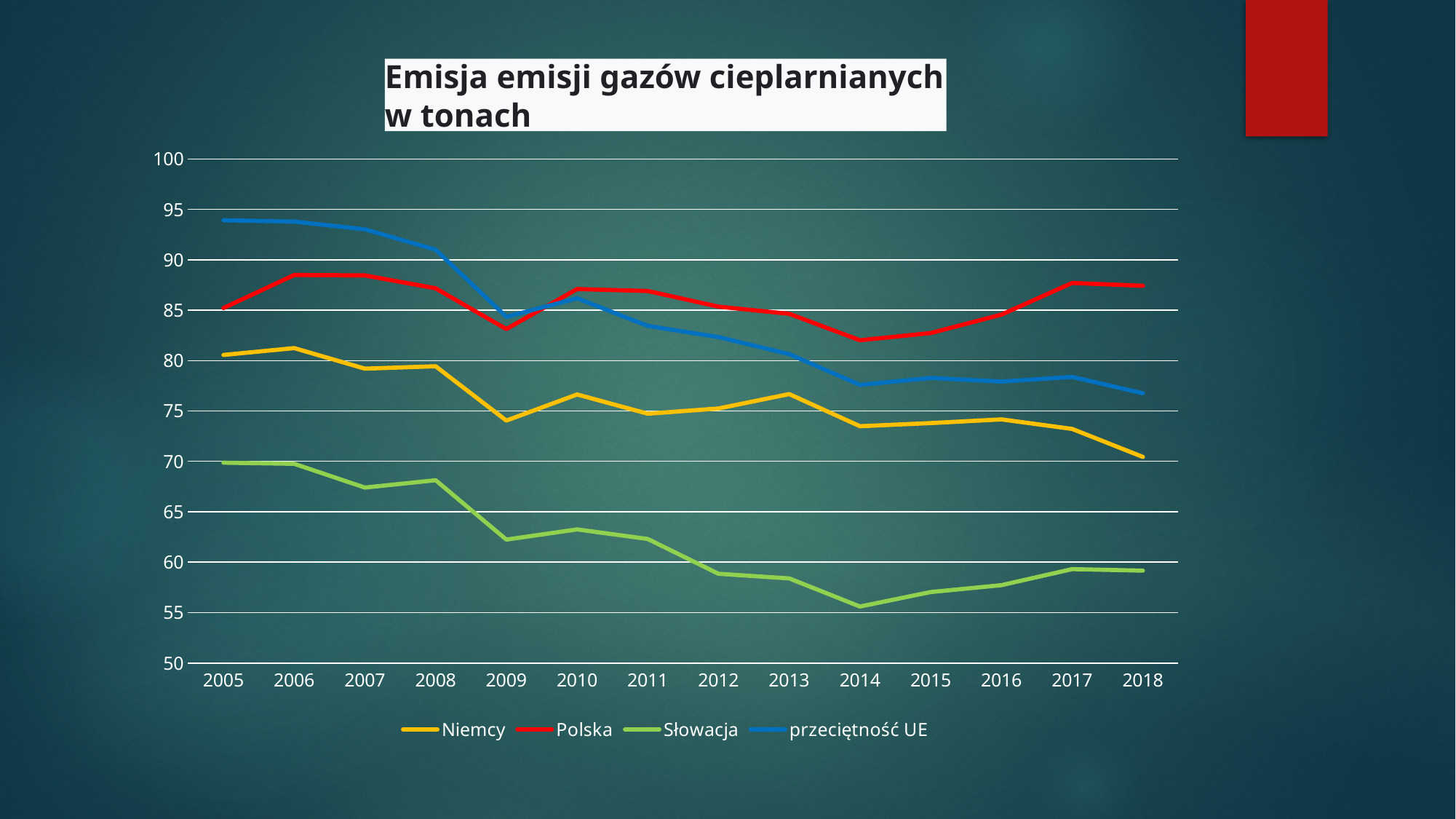
Is the value for Polska in 2006 greater or less than 85? greater What is the title of the chart? Emisja emisji gazów cieplarnianych w tonach Does the przeciętność UE line rise or fall overall from 2005 to 2018? fall In which year does the Niemcy line reach its lowest value? 2018 In 2005, which is higher: Polska or przeciętność UE? przeciętność UE Is the value for Słowacja in 2014 greater or less than 60? less In 2018, which is higher: Polska or przeciętność UE? Polska What kind of chart is shown on the slide? line chart Is the value for Niemcy in 2018 greater or less than 75? less How many series does the legend list? 4 Does the Słowacja line rise or fall overall from 2005 to 2018? fall How many years are plotted along the x axis? 14